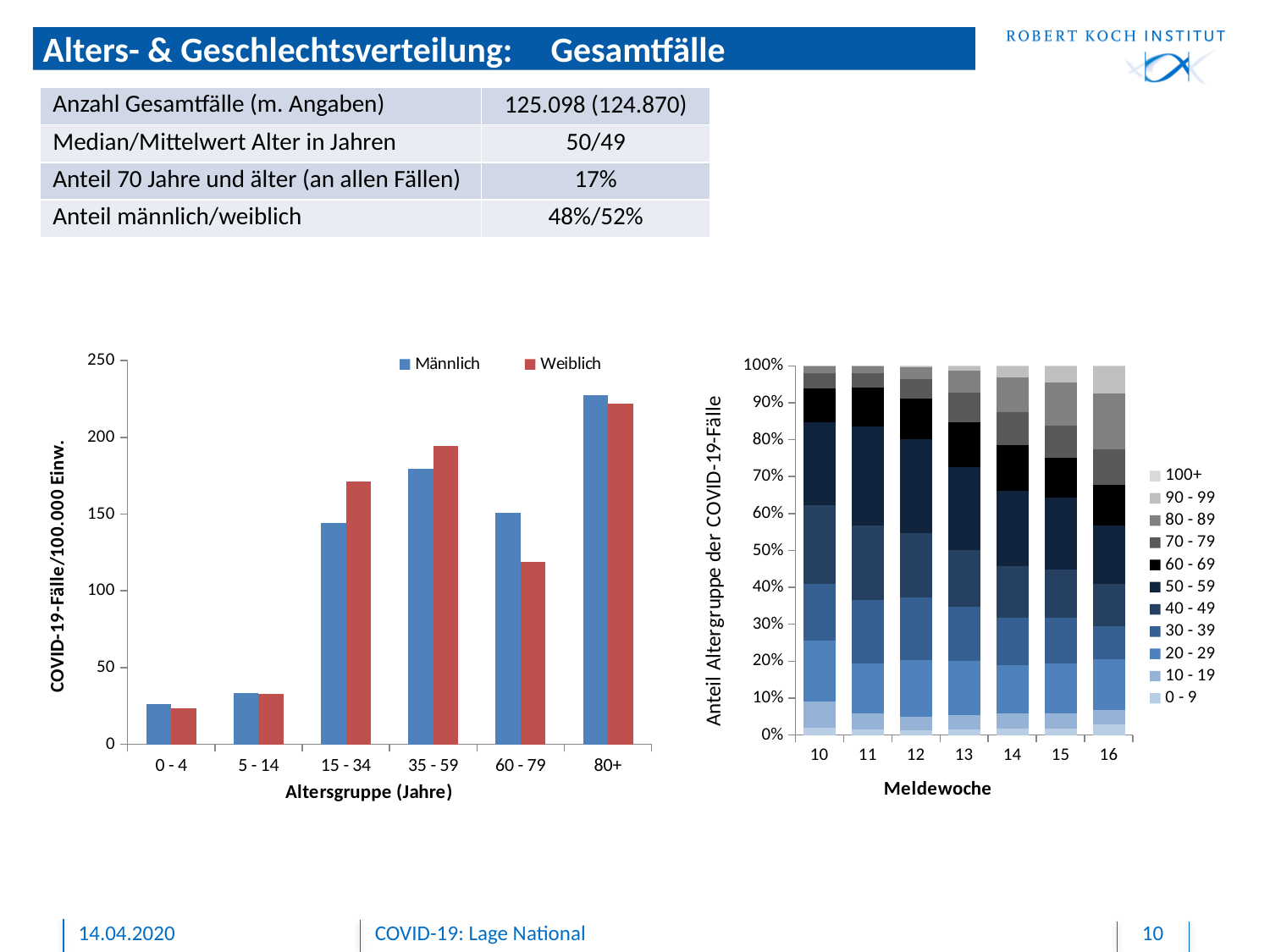
In the left chart (COVID-19-Fälle/100.000 Einw.), how many series does the legend list? 2 In the right chart (Anteil Altersgruppe der COVID-19-Fälle by Meldewoche), how many age groups does the legend list? 11 In the left chart (COVID-19-Fälle/100.000 Einw.), which age group has the lowest value for Weiblich? 0 - 4 In the right chart (Anteil Altersgruppe der COVID-19-Fälle by Meldewoche), how many Meldewochen are shown on the x axis? 7 In the left chart (COVID-19-Fälle/100.000 Einw.), how many age groups are shown on the x axis? 6 In the left chart (COVID-19-Fälle/100.000 Einw.), is the Männlich value for 35 - 59 greater or less than 150? greater What kind of chart is the left chart showing COVID-19-Fälle/100.000 Einw. by Altersgruppe? bar chart What is the x-axis title of the left chart? Altersgruppe (Jahre) In the left chart (COVID-19-Fälle/100.000 Einw.), for the 15 - 34 age group, which is larger: Männlich or Weiblich? Weiblich In the left chart (COVID-19-Fälle/100.000 Einw.), for the 60 - 79 age group, which is larger: Männlich or Weiblich? Männlich In the left chart (COVID-19-Fälle/100.000 Einw.), which age group has the highest value for Männlich? 80+ In the left chart (COVID-19-Fälle/100.000 Einw.), is the Weiblich value for 60 - 79 greater or less than 150? less